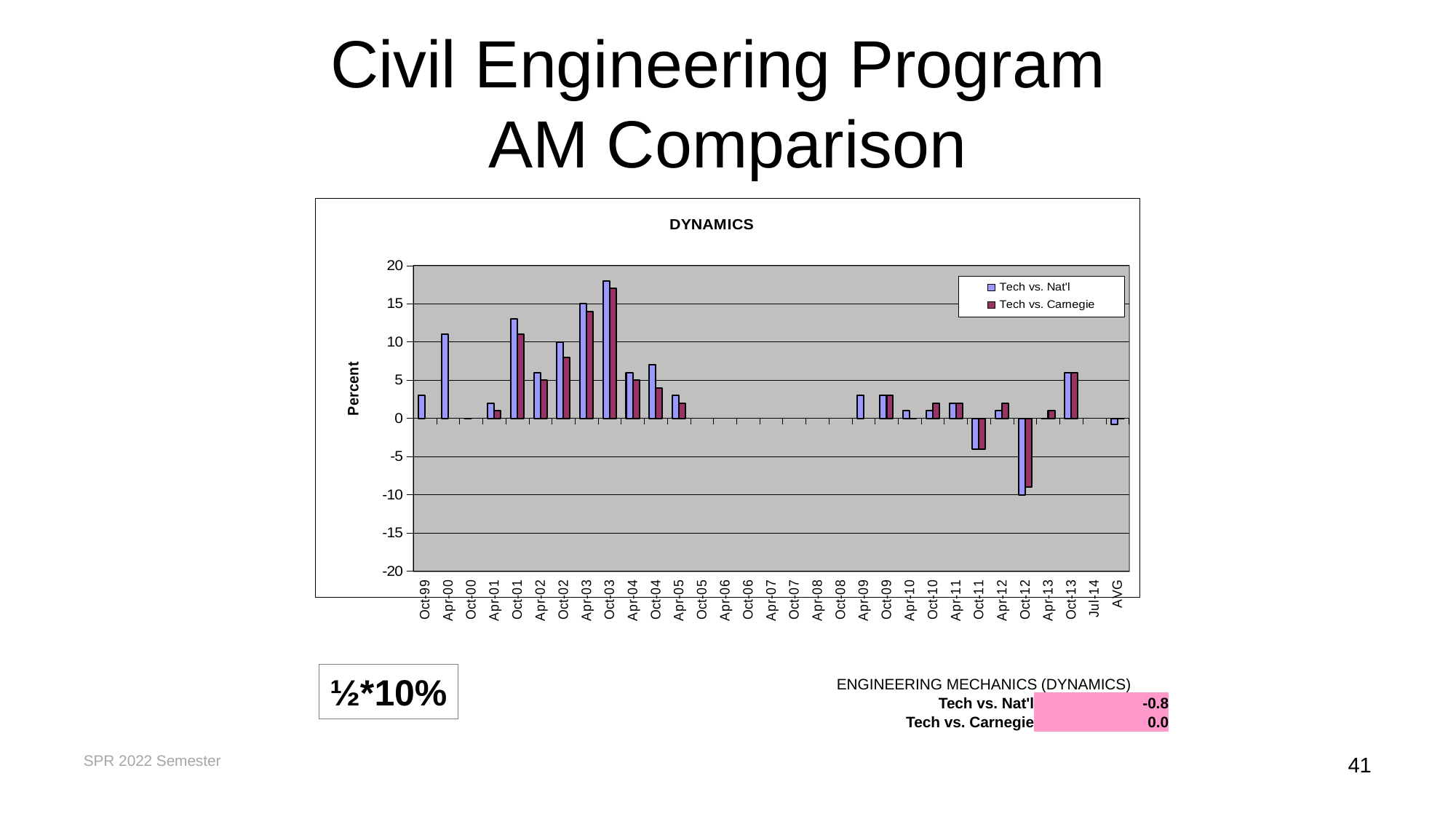
Is the Tech vs. Nat'l value for Oct-01 greater or less than 10? greater What is the label on the vertical axis of the chart? Percent Is the Tech vs. Nat'l value for Oct-03 greater or less than 15? greater How many categories are shown along the x axis of the chart? 31 Is the Tech vs. Nat'l value for Oct-12 greater or less than -5? less Which category has the lowest Tech vs. Nat'l value? Oct-12 What is the title of the chart? DYNAMICS Which is larger for Oct-01: the Tech vs. Nat'l value or the Tech vs. Carnegie value? Tech vs. Nat'l How many series does the legend of the DYNAMICS chart list? 2 Which is larger for Tech vs. Nat'l: the value for Oct-03 or the value for Apr-03? Oct-03 What kind of chart is shown on the slide? bar chart Which category has the highest Tech vs. Nat'l value? Oct-03